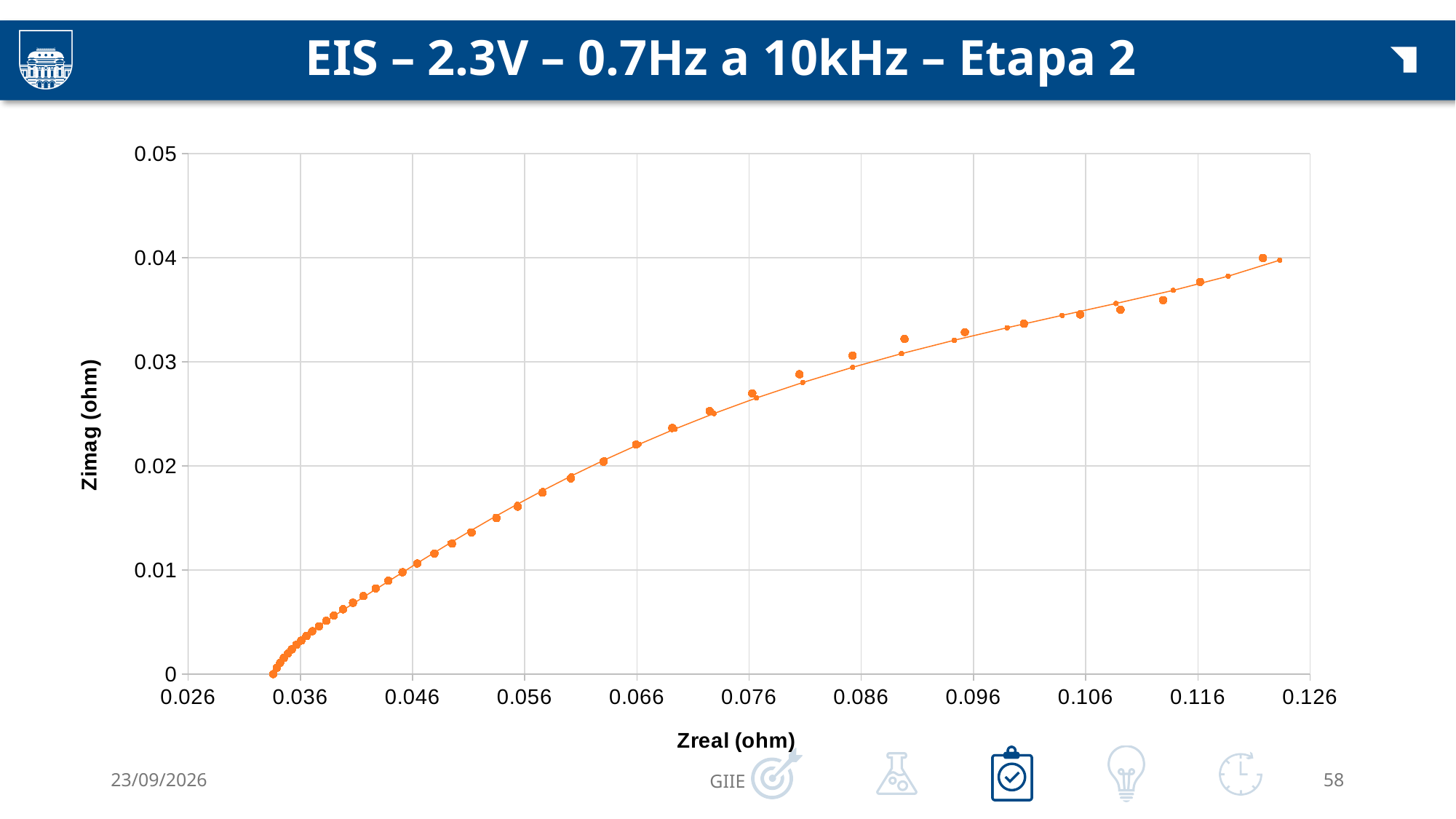
What kind of chart is shown on the slide? scatter chart with a line Does Zimag rise or fall as Zreal increases along the x axis? rise What is the label of the vertical axis? Zimag (ohm) Is the Zimag value at Zreal of about 0.076 greater or less than 0.02? greater What is the title of the chart on the slide? EIS – 2.3V – 0.7Hz a 10kHz – Etapa 2 Is the Zreal value of the leftmost plotted point greater or less than 0.036? less Is the highest Zimag value plotted greater or less than 0.05? less What is the maximum value shown on the vertical axis? 0.05